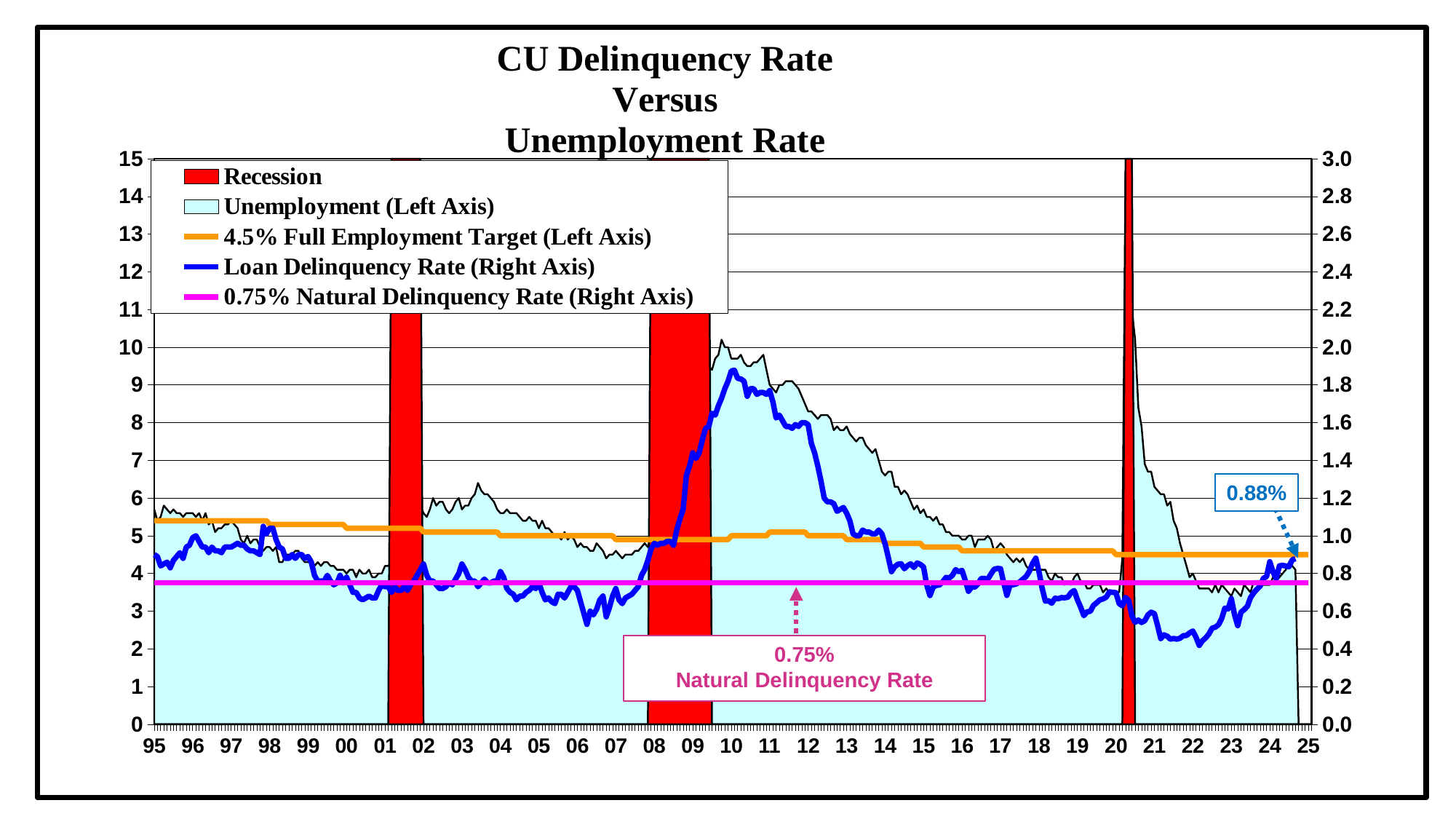
What kind of chart is used to plot the Loan Delinquency Rate? line chart In which year does the Loan Delinquency Rate reach its highest point? 2010 How many entries does the legend list? 5 What is the labelled value of the Loan Delinquency Rate at the end of the series (2024)? 0.88% Is the unemployment rate in 2010 greater or less than 8 on the left axis? greater How many recession bands are shaded on the chart? 3 What colour are the recession periods shaded? red Between 2010 and 2015, does the unemployment rate rise or fall? fall What is the Natural Delinquency Rate shown by the magenta line? 0.75% Is the Loan Delinquency Rate higher in 2010 or in 2022? 2010 What is the title of the chart? CU Delinquency Rate Versus Unemployment Rate Is the Loan Delinquency Rate in 2022 greater or less than 0.6 on the right axis? less